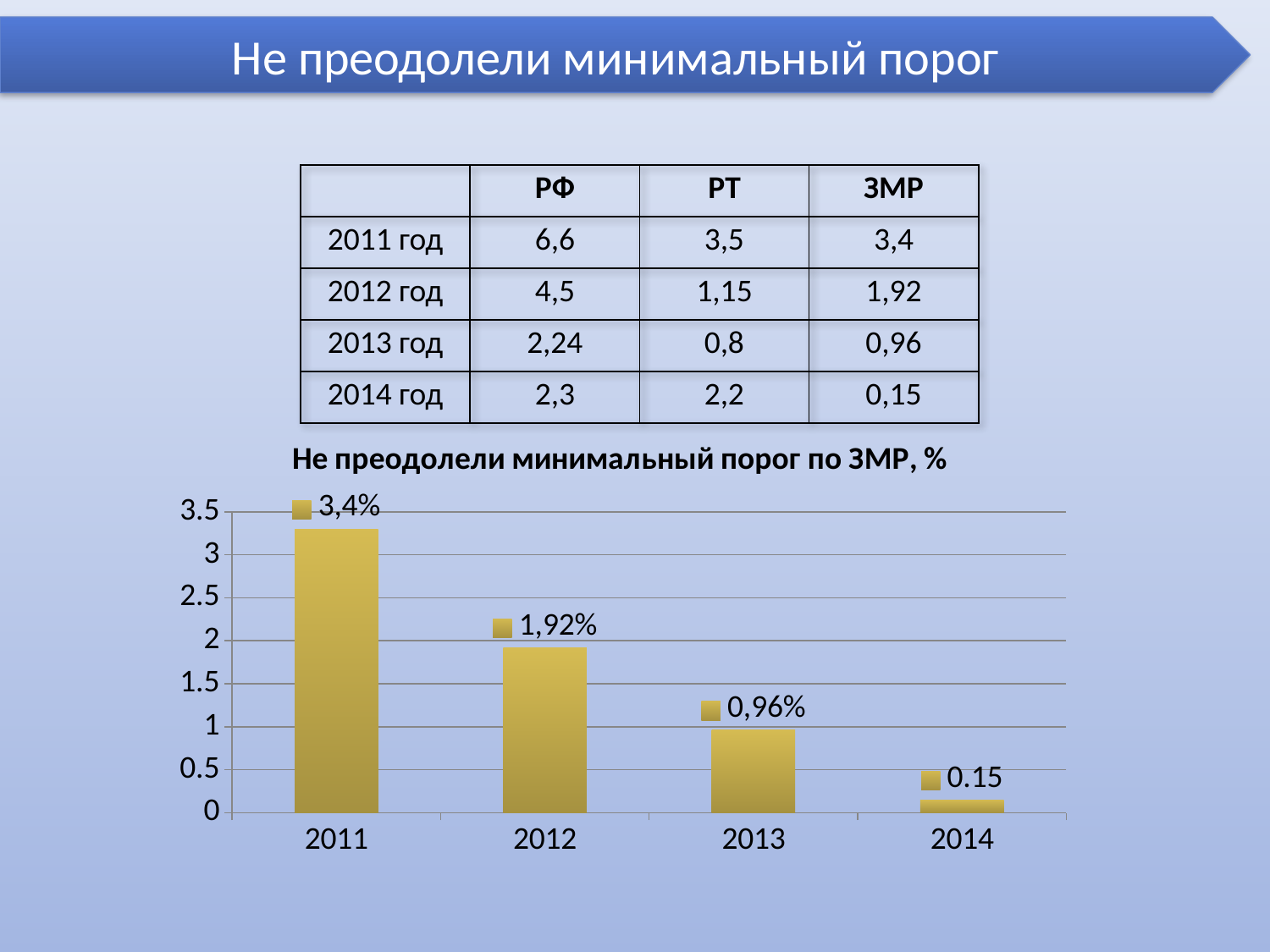
What is the difference between the values for 2011 and 2012 in the chart? 1,48 Which year has the highest bar in the chart? 2011 Do the values in the chart rise or fall from 2011 to 2014? Fall What is the value for 2014 in the chart? 0.15 Which year has the lowest bar in the chart? 2014 What is the difference between the values for 2012 and 2013 in the chart? 0,96 Which is larger in the chart, the value for 2012 or the value for 2013? 2012 What is the value for 2012 in the chart? 1,92% What is the value for 2011 in the chart? 3,4% What is the value for 2013 in the chart? 0,96% What type of chart is shown on the slide? Bar chart How many bars are shown in the chart? 4